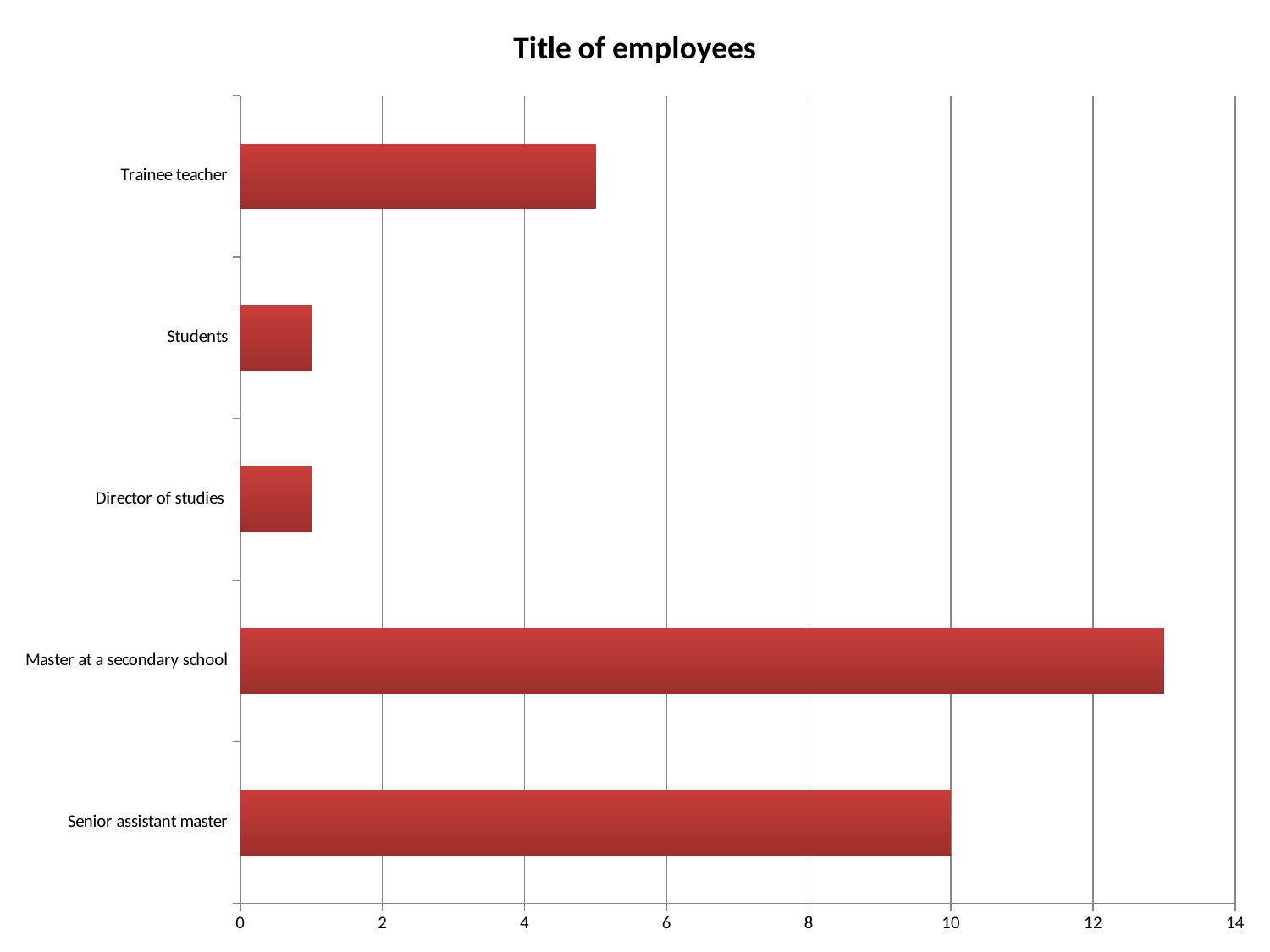
What is the value for Senior assistant master? 10 What colour are the bars in the chart? red Which category has the highest value? Master at a secondary school Is the value for Trainee teacher greater or less than 6? less Is the value for Students greater or less than 2? less What type of chart is shown on the slide? bar chart Which is larger, the value for Trainee teacher or the value for Director of studies? Trainee teacher What is the title of the chart? Title of employees Is the value for Master at a secondary school greater or less than 12? greater Which is larger, the value for Senior assistant master or the value for Master at a secondary school? Master at a secondary school How many categories are plotted in the chart? 5